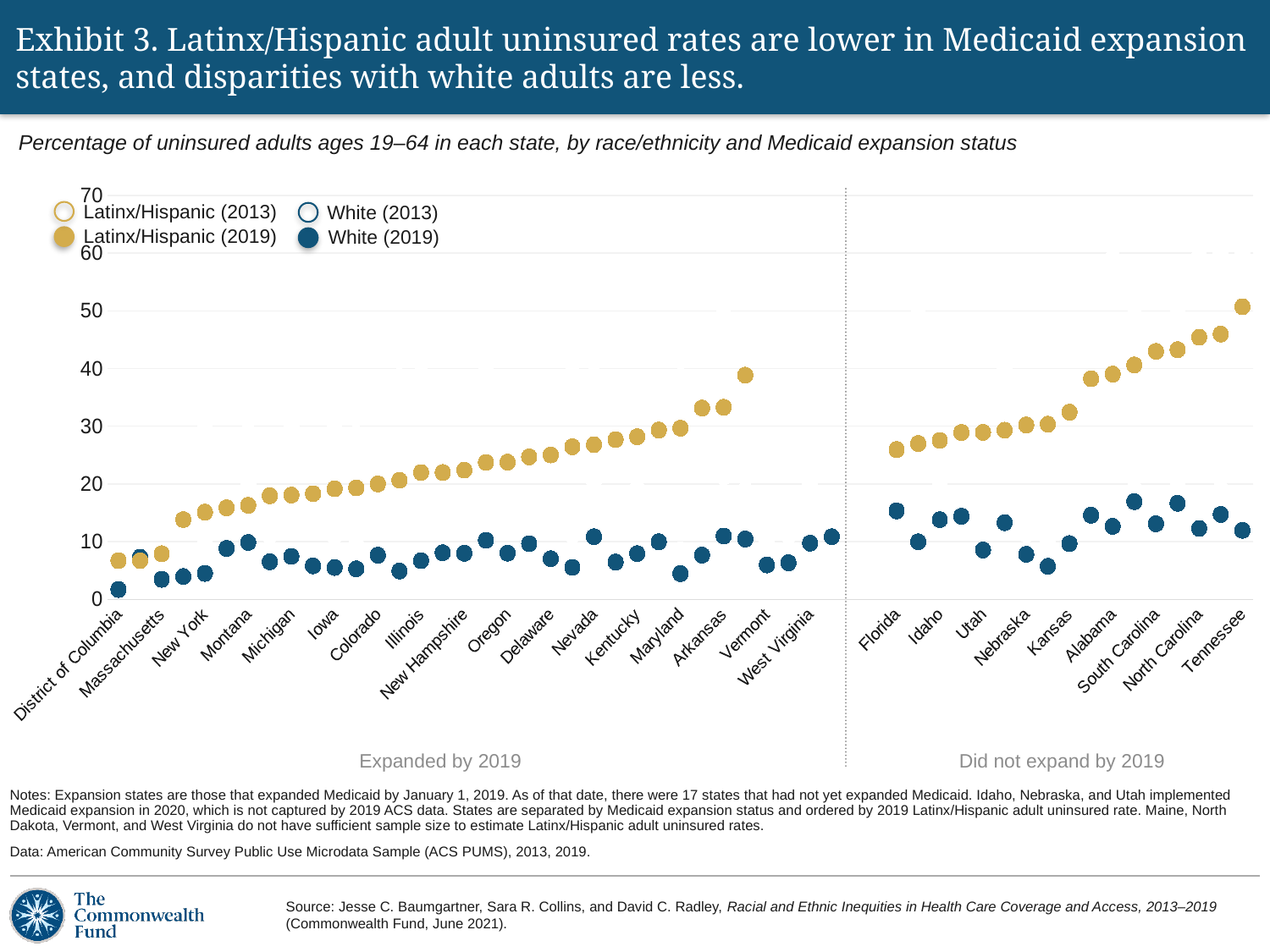
What are the two group labels shown beneath the x axis? Expanded by 2019; Did not expand by 2019 Which is larger, the Latinx/Hispanic (2019) value for Tennessee or for Florida? Tennessee Is the Latinx/Hispanic (2019) value for Tennessee greater or less than 40? greater Is the Latinx/Hispanic (2019) value for District of Columbia greater or less than 10? less Is the White (2019) value for Massachusetts greater or less than 10? less In Tennessee, which is larger, the Latinx/Hispanic (2019) value or the White (2019) value? Latinx/Hispanic (2019) Do the Latinx/Hispanic (2019) values rise or fall from left to right within the 'Did not expand by 2019' group? rise What kind of chart is shown on the slide? Scatter (dot) chart Which state has the highest Latinx/Hispanic (2019) uninsured rate? Tennessee How many series does the legend list? 4